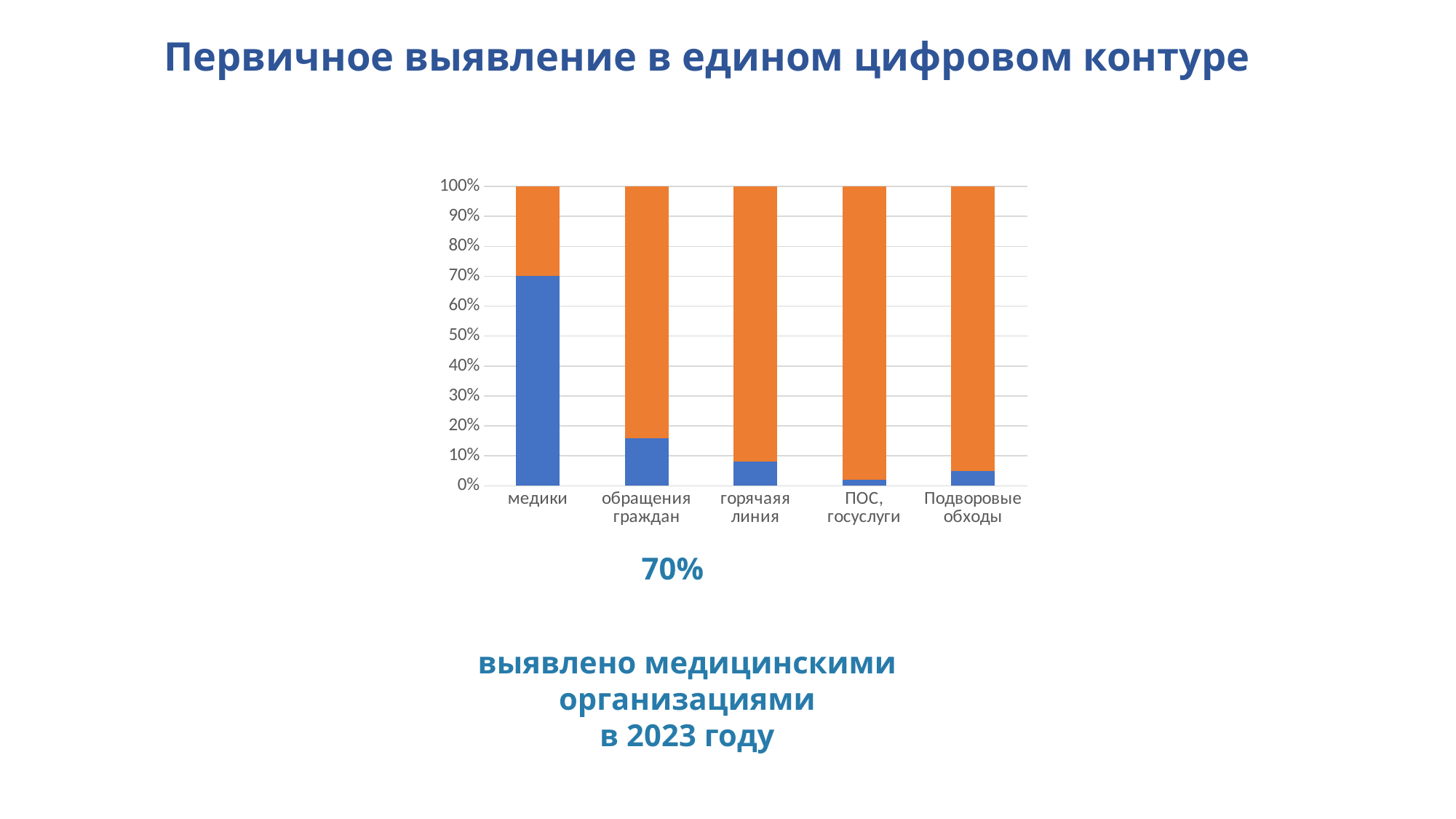
Is the blue segment for обращения граждан greater or less than 20%? less What is the value of the blue segment for медики? 70% Which has a larger blue segment, обращения граждан or горячаяя линия? обращения граждан What is the title of the slide above the chart? Первичное выявление в едином цифровом контуре Is the blue segment for горячаяя линия greater or less than 10%? less How many categories are shown on the x axis of the chart? 5 What is the total height of each stacked bar in the chart? 100% Which has a larger blue segment, Подворовые обходы or ПОС, госуслуги? Подворовые обходы Which category has the largest blue segment? медики What kind of chart is shown on the slide? bar chart Which category has the smallest blue segment? ПОС, госуслуги Is the blue segment for Подворовые обходы greater or less than 10%? less